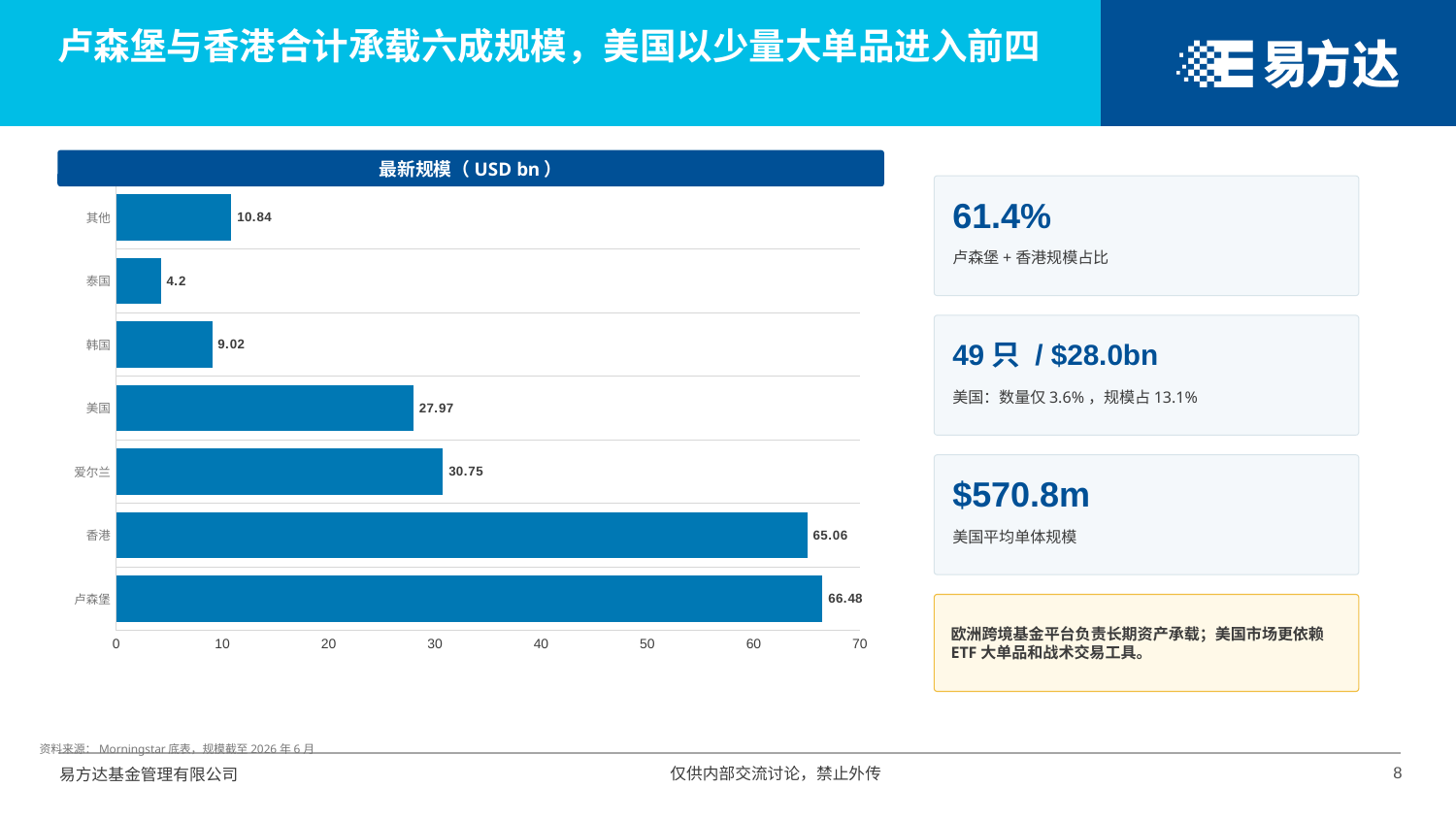
What is the value for 香港? 65.06 What is the title of the chart? 最新规模（USD bn） How many categories are shown in the chart? 7 Which category has the highest value? 卢森堡 Is the value for 美国 greater or less than 30? less Which is larger, the value for 其他 or the value for 韩国? 其他 What is the value for 卢森堡? 66.48 What type of chart is shown on the slide? bar chart What is the value for 美国? 27.97 What is the difference between the values for 爱尔兰 and 美国? 2.78 What is the value for 泰国? 4.2 Which category has the lowest value? 泰国